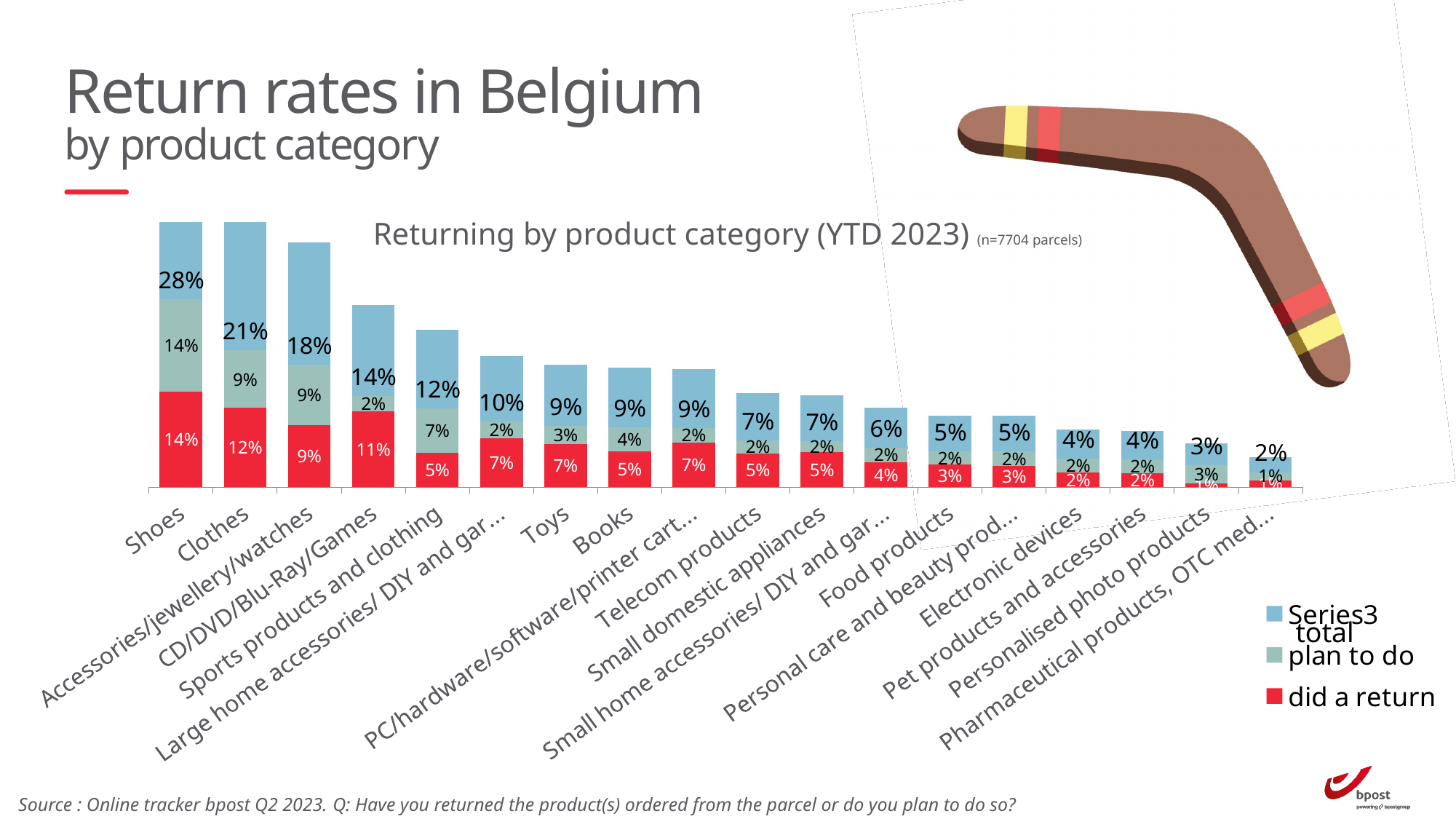
Which product category has the highest total return rate? Shoes How many product categories are shown on the chart? 18 What is the difference between the total return rate for Shoes and for Clothes? 7% What is the 'plan to do' value for Sports products and clothing? 7% How many series does the legend list? 3 Which has a higher 'did a return' value, Toys or Books? Toys What is the title of the chart? Returning by product category (YTD 2023) What is the 'did a return' value for CD/DVD/Blu-Ray/Games? 11% What is the 'did a return' value for Clothes? 12% Which product category has the lowest total return rate? Pharmaceutical products, OTC med... What kind of chart is shown on the slide? Stacked bar chart What is the total return rate shown for Shoes? 28%